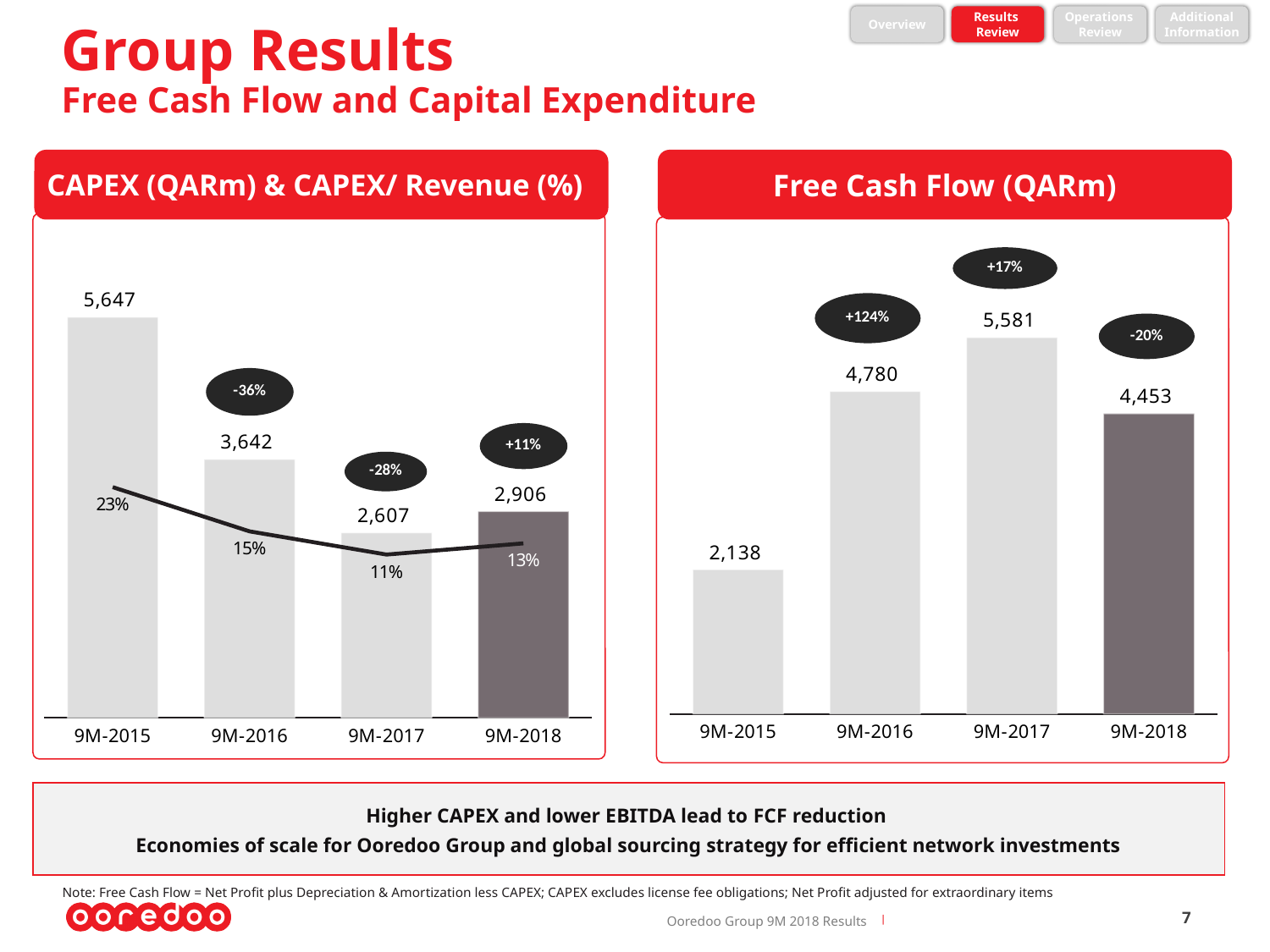
In the Free Cash Flow (QARm) chart, which period has the highest free cash flow? 9M-2017 What type of chart is the Free Cash Flow (QARm) chart? bar chart In the Free Cash Flow (QARm) chart, what is the difference between the 9M-2017 and 9M-2018 values? 1,128 In the CAPEX (QARm) & CAPEX/ Revenue (%) chart, how many periods are shown on the x axis? 4 In the Free Cash Flow (QARm) chart, is the value for 9M-2015 larger or smaller than the value for 9M-2018? smaller In the CAPEX (QARm) & CAPEX/ Revenue (%) chart, what is the difference in CAPEX between 9M-2018 and 9M-2017? 299 In the Free Cash Flow (QARm) chart, what percentage change is shown in the bubble above the 9M-2018 bar? -20% In the CAPEX (QARm) & CAPEX/ Revenue (%) chart, which period has the lowest CAPEX? 9M-2017 In the CAPEX (QARm) & CAPEX/ Revenue (%) chart, what is the CAPEX value for 9M-2015? 5,647 In the Free Cash Flow (QARm) chart, what is the value for 9M-2016? 4,780 In the CAPEX (QARm) & CAPEX/ Revenue (%) chart, what percentage change is shown in the bubble above the 9M-2016 bar? -36% In the CAPEX (QARm) & CAPEX/ Revenue (%) chart, what is the CAPEX/Revenue percentage for 9M-2017? 11%